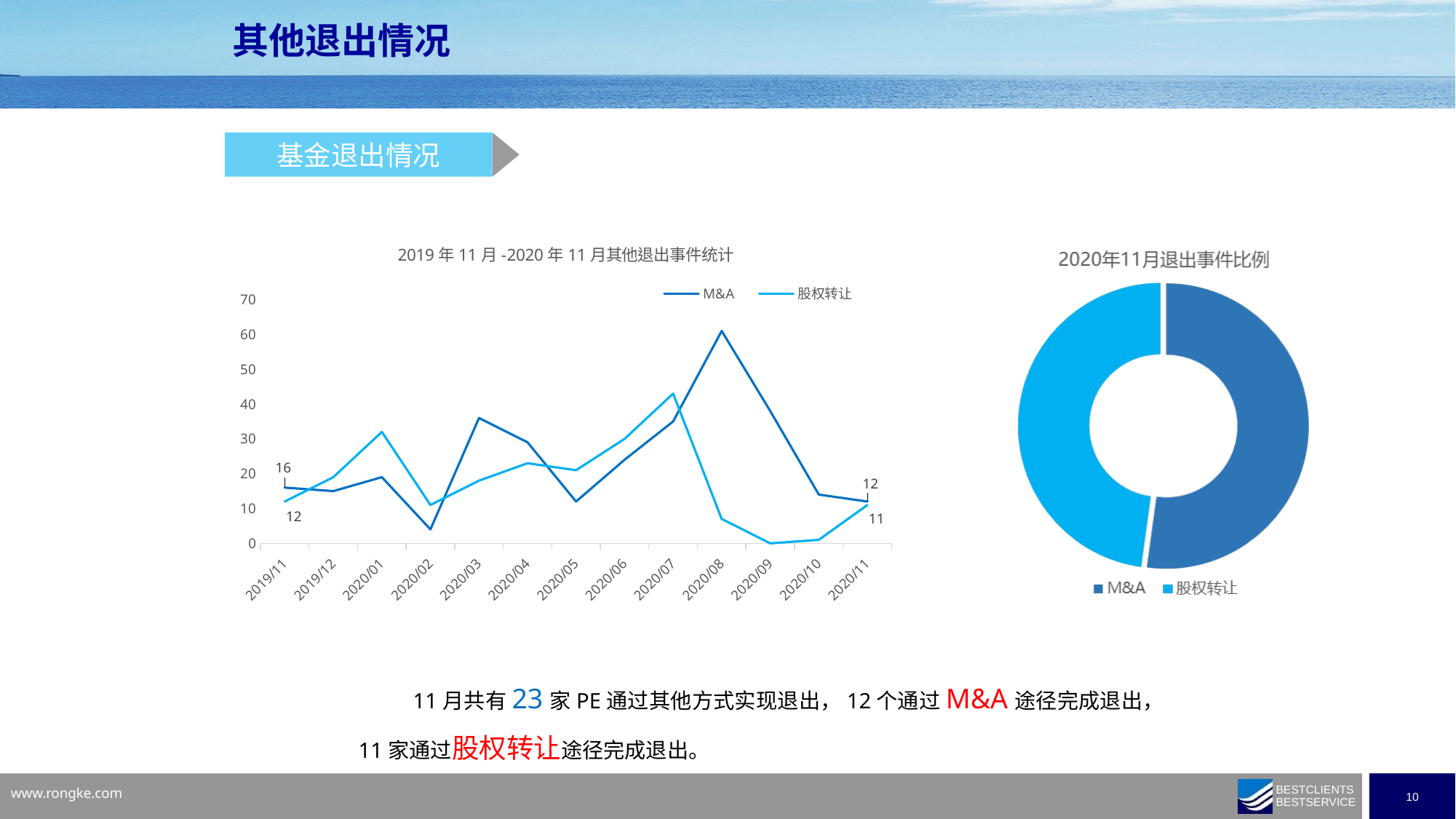
What kind of chart is the chart titled "2019 年 11 月 -2020 年 11 月其他退出事件统计"? line chart In the line chart "2019 年 11 月 -2020 年 11 月其他退出事件统计", what is the 股权转让 value for 2020/11? 11 In the line chart "2019 年 11 月 -2020 年 11 月其他退出事件统计", in which month does the M&A series reach its highest value? 2020/08 In the line chart "2019 年 11 月 -2020 年 11 月其他退出事件统计", how many series does the legend list? 2 In the line chart "2019 年 11 月 -2020 年 11 月其他退出事件统计", which series has the larger value at 2019/11, M&A or 股权转让? M&A In the line chart "2019 年 11 月 -2020 年 11 月其他退出事件统计", is the M&A value for 2020/08 greater or less than 50? greater In the line chart "2019 年 11 月 -2020 年 11 月其他退出事件统计", what is the M&A value for 2019/11? 16 In the chart "2020年11月退出事件比例", what are the two legend entries? M&A and 股权转让 In the line chart "2019 年 11 月 -2020 年 11 月其他退出事件统计", what is the M&A value for 2020/11? 12 What kind of chart is the chart titled "2020年11月退出事件比例"? pie chart (donut) In the line chart "2019 年 11 月 -2020 年 11 月其他退出事件统计", what is the difference between the M&A value for 2019/11 and the M&A value for 2020/11? 4 In the line chart "2019 年 11 月 -2020 年 11 月其他退出事件统计", how many months are shown on the x axis? 13